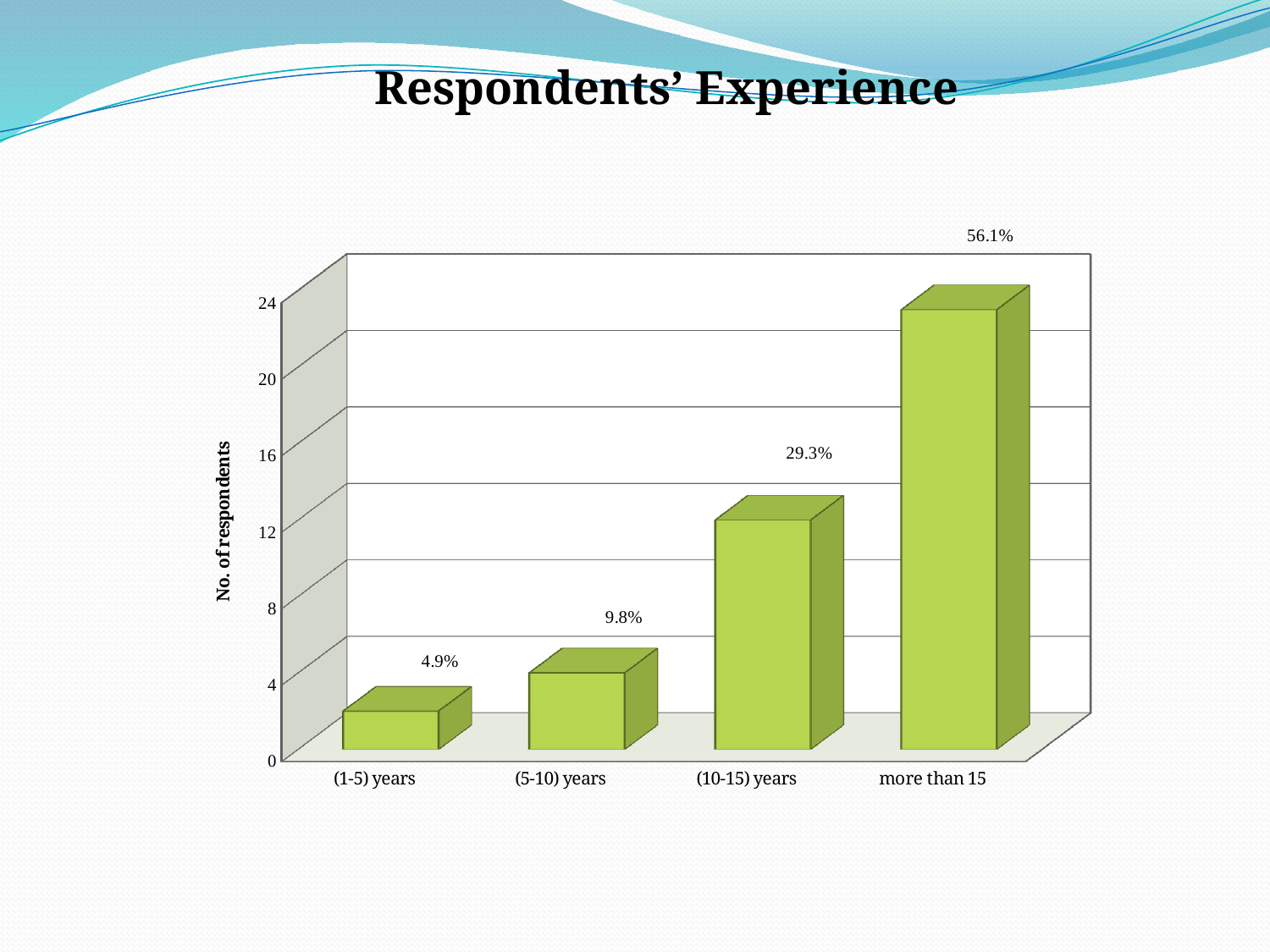
What kind of chart is shown on the slide? bar chart How many experience categories are shown on the x axis? 4 Is the number of respondents for more than 15 greater or less than 20? greater Which experience category has the lowest number of respondents? (1-5) years What percentage label is shown for the (1-5) years category? 4.9% What is the difference between the percentage labels for more than 15 and (10-15) years? 26.8% Which experience category has the highest number of respondents? more than 15 What percentage label is shown for the (5-10) years category? 9.8% What percentage label is shown for the (10-15) years category? 29.3% What percentage label is shown for the more than 15 category? 56.1% What is the title of the chart? Respondents' Experience What is the label on the vertical axis? No. of respondents